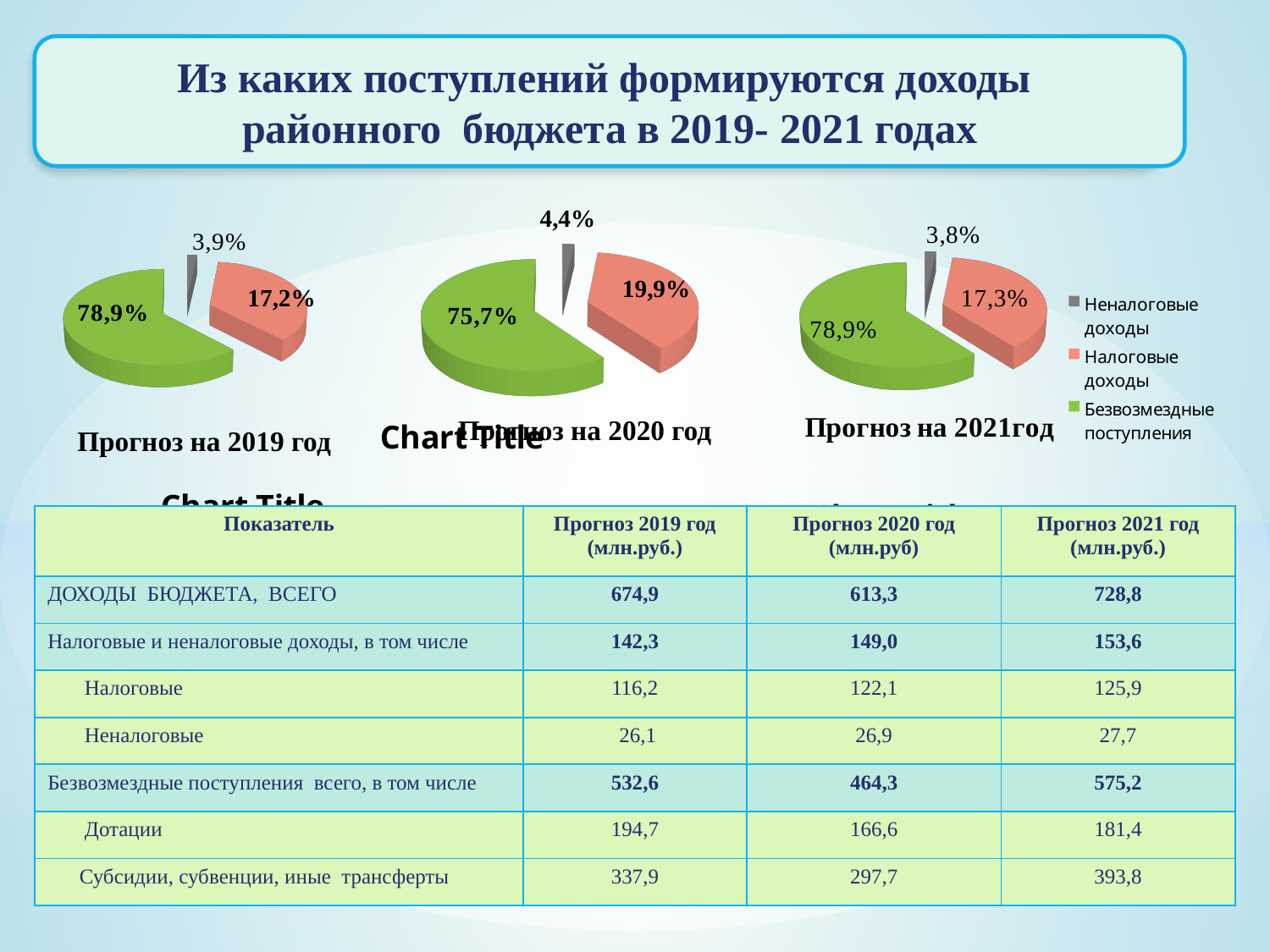
In the pie chart 'Прогноз на 2021год', what is the difference between the shares of Безвозмездные поступления and Налоговые доходы? 61,6% What colour represents Налоговые доходы in the pie charts? Pink (salmon) Which is larger: the share of Налоговые доходы in the 'Прогноз на 2020 год' chart or in the 'Прогноз на 2019 год' chart? Прогноз на 2020 год In the pie chart 'Прогноз на 2019 год', which category has the smallest slice? Неналоговые доходы What type of chart is 'Прогноз на 2020 год'? Pie chart In the pie chart 'Прогноз на 2020 год', what share is shown for Налоговые доходы? 19,9% How many entries does the legend next to the 'Прогноз на 2021год' chart list? 3 In the pie chart 'Прогноз на 2021год', what share is shown for Неналоговые доходы? 3,8% In the pie chart 'Прогноз на 2020 год', what is the share of Неналоговые доходы? 4,4% In the pie chart 'Прогноз на 2020 год', which category has the largest slice? Безвозмездные поступления In the pie chart 'Прогноз на 2019 год', what share is shown for Безвозмездные поступления? 78,9% How many slices does the pie chart 'Прогноз на 2019 год' have? 3